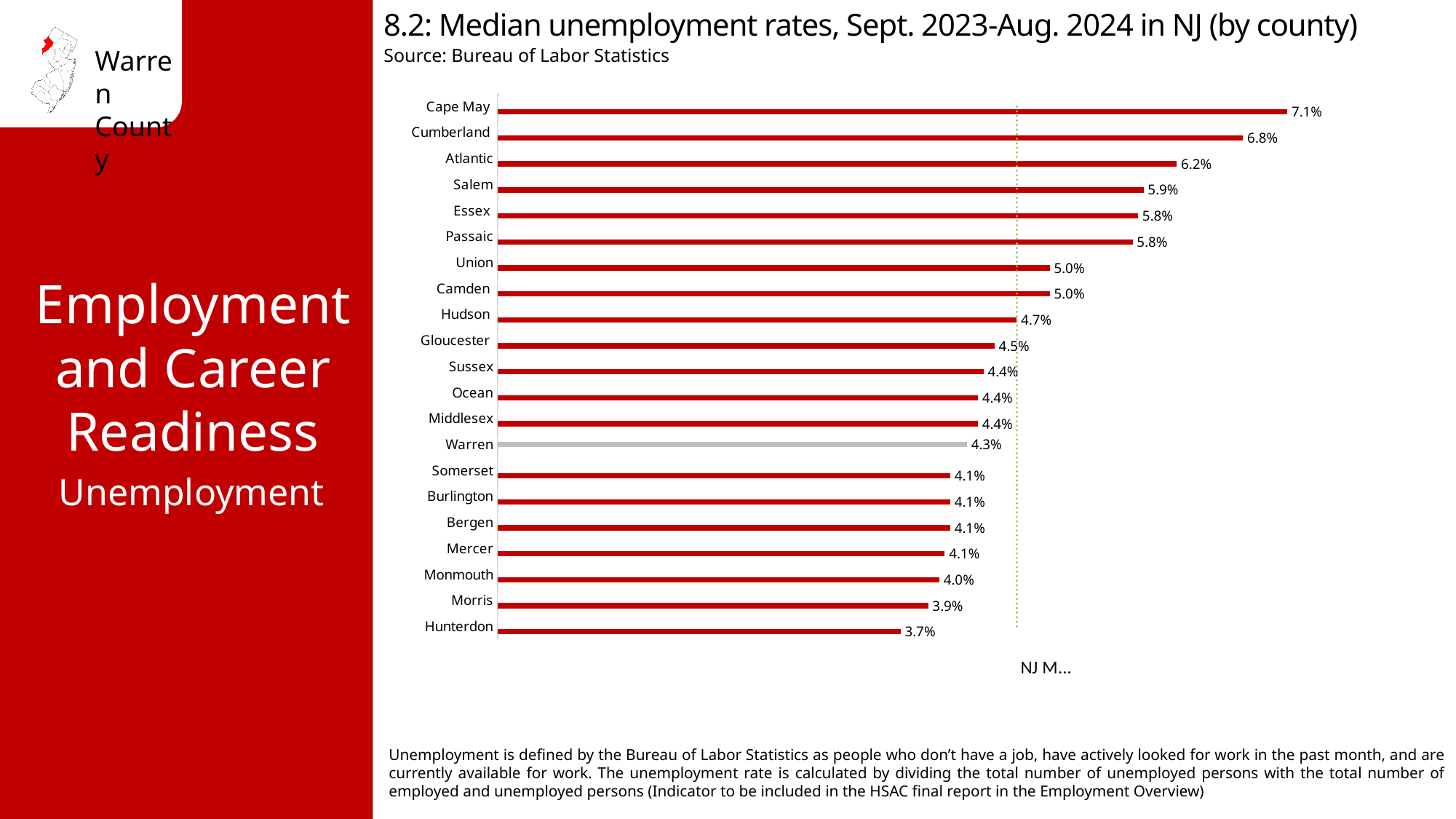
What is the median unemployment rate for Warren? 4.3% What is the difference between the median unemployment rates of Cumberland and Warren? 2.5% What is the median unemployment rate for Cape May? 7.1% Which county has the lowest median unemployment rate? Hunterdon Which has a higher median unemployment rate, Atlantic or Salem? Atlantic What is the median unemployment rate for Hudson? 4.7% Which county's bar is shown in grey rather than red? Warren What kind of chart is shown on the slide? Bar chart How many counties are shown in the chart? 21 What is the difference between the median unemployment rates of Cape May and Hunterdon? 3.4% Which county has the highest median unemployment rate? Cape May Which has a higher median unemployment rate, Morris or Monmouth? Monmouth